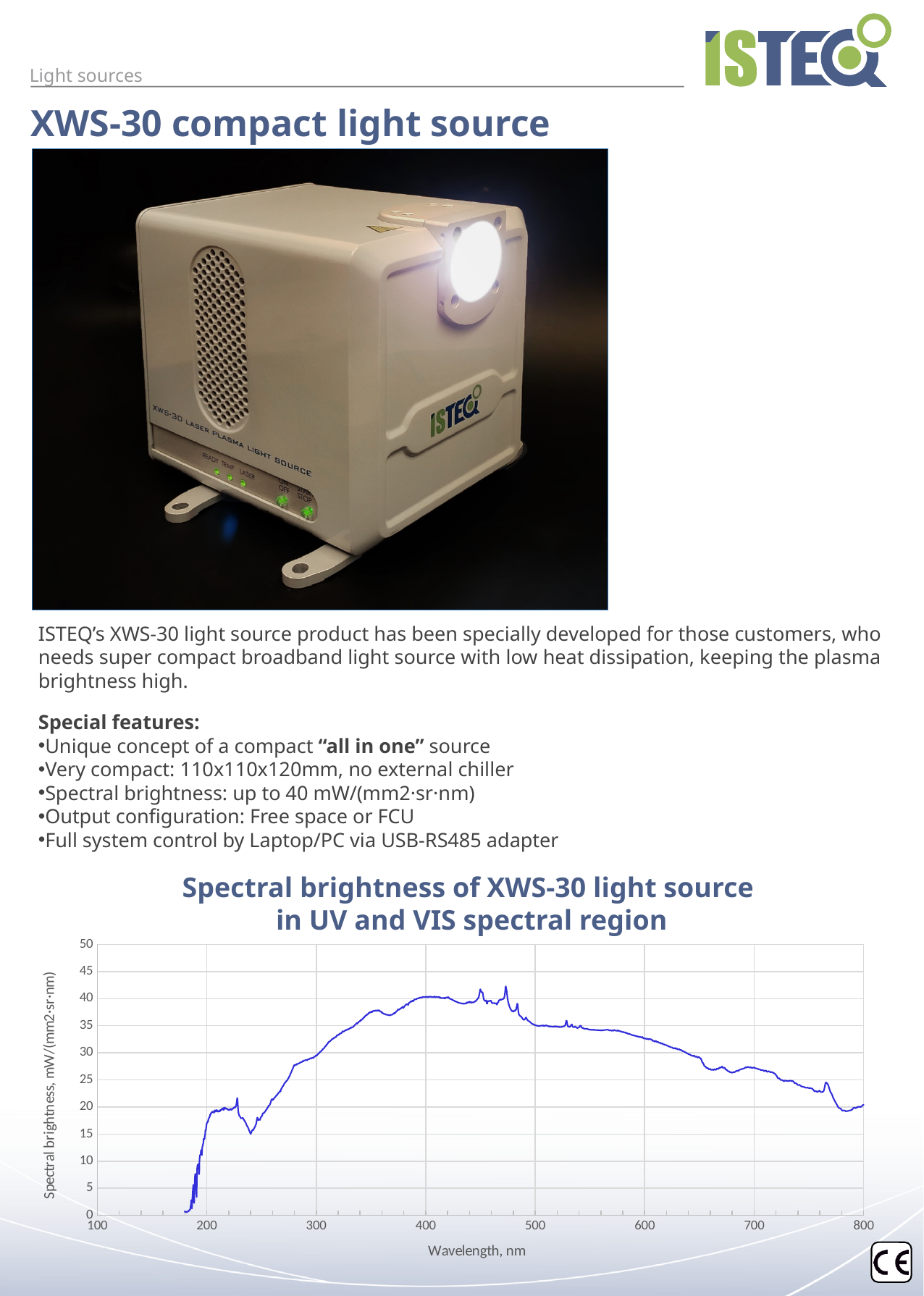
How many lines are plotted on the spectral brightness chart? 1 On the spectral brightness chart, does the curve rise or fall between 500 nm and 750 nm? fall On the spectral brightness chart, is the value at 300 nm greater or less than 25? greater On the spectral brightness chart, does the curve rise or fall between 250 nm and 400 nm? rise On the spectral brightness chart, is the value at 200 nm greater or less than 25? less On the spectral brightness chart, is the value at 400 nm greater or less than 35? greater What kind of chart is shown under the title "Spectral brightness of XWS-30 light source in UV and VIS spectral region"? Line chart What is the label of the x axis of the spectral brightness chart? Wavelength, nm On the spectral brightness chart, which is larger: the value at 400 nm or the value at 800 nm? 400 nm What is the label of the y axis of the spectral brightness chart? Spectral brightness, mW/(mm2·sr·nm)